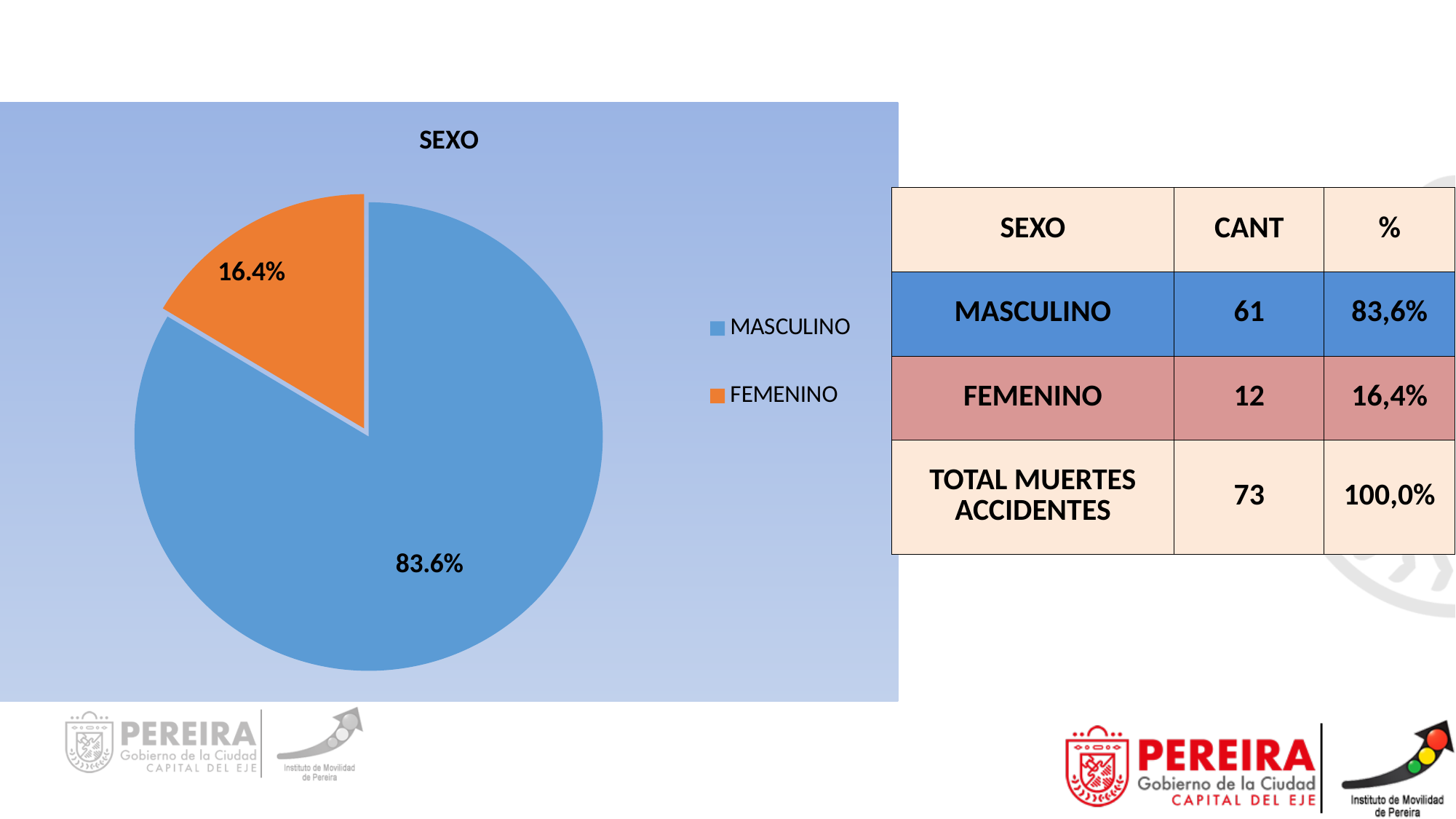
What is the difference in percentage points between the MASCULINO and FEMENINO slices? 67.2 How many entries does the legend list? 2 What kind of chart is shown on the slide? pie chart What percentage does the FEMENINO slice show? 16.4% Which category has the largest slice of the pie? MASCULINO Which slice is larger, MASCULINO or FEMENINO? MASCULINO What percentage does the MASCULINO slice show? 83.6% What share of the pie does the FEMENINO slice represent? 16.4% How many slices does the pie chart have? 2 What is the title of the chart? SEXO What colour is the FEMENINO slice? orange Which category has the smallest slice of the pie? FEMENINO